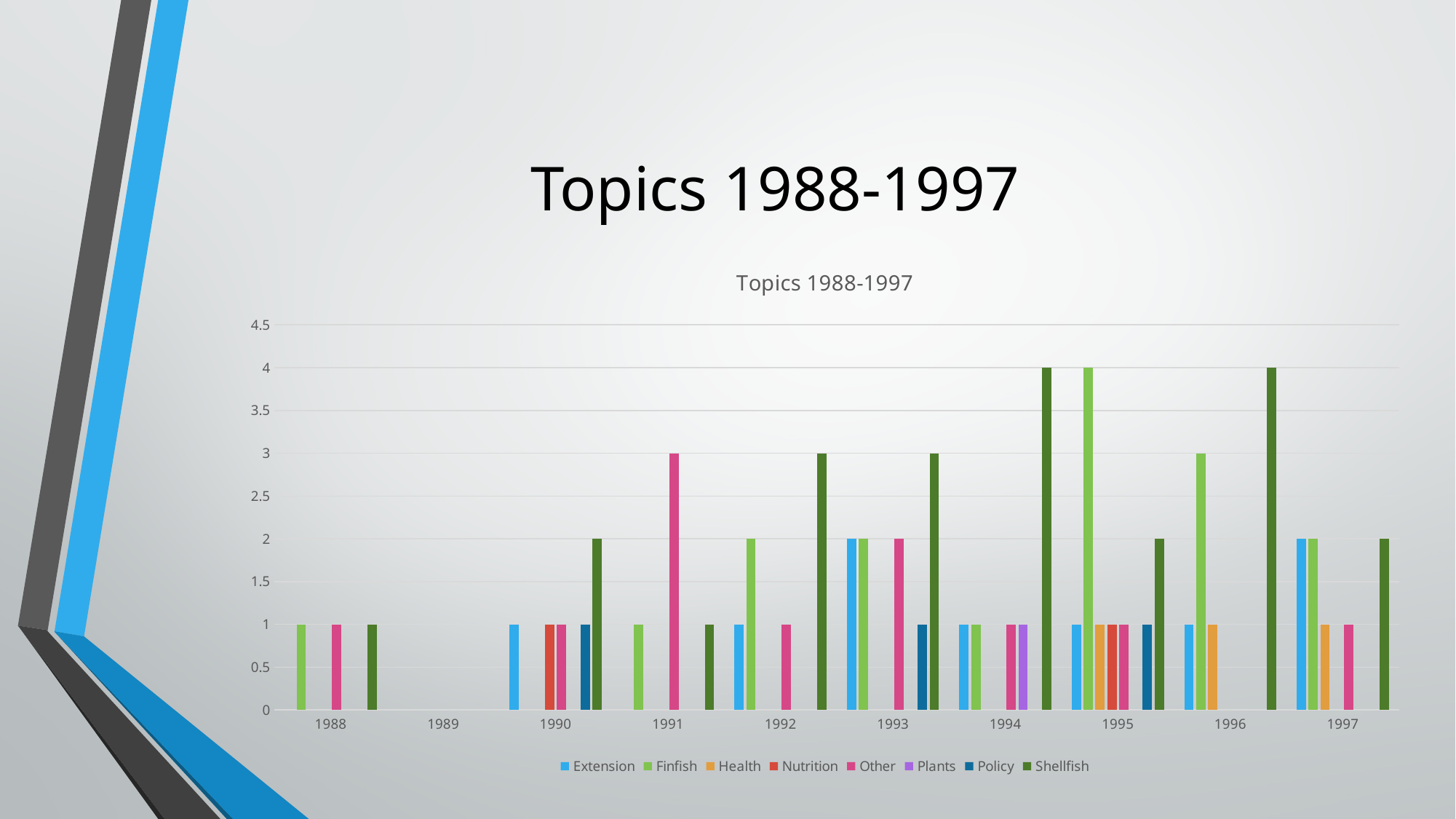
How many years are shown on the x axis? 10 What is the value for Finfish in 1995? 4 Is the value for Shellfish in 1996 greater or less than 3? greater In which year is the Finfish value highest? 1995 How many series does the legend list? 8 Which year has no bars at all? 1989 In 1996, which is larger: Finfish or Extension? Finfish What is the value for Other in 1991? 3 What kind of chart is shown on the slide? bar chart What is the difference between the Shellfish and Finfish values in 1993? 1 What is the value for Shellfish in 1994? 4 What is the title of the chart? Topics 1988-1997